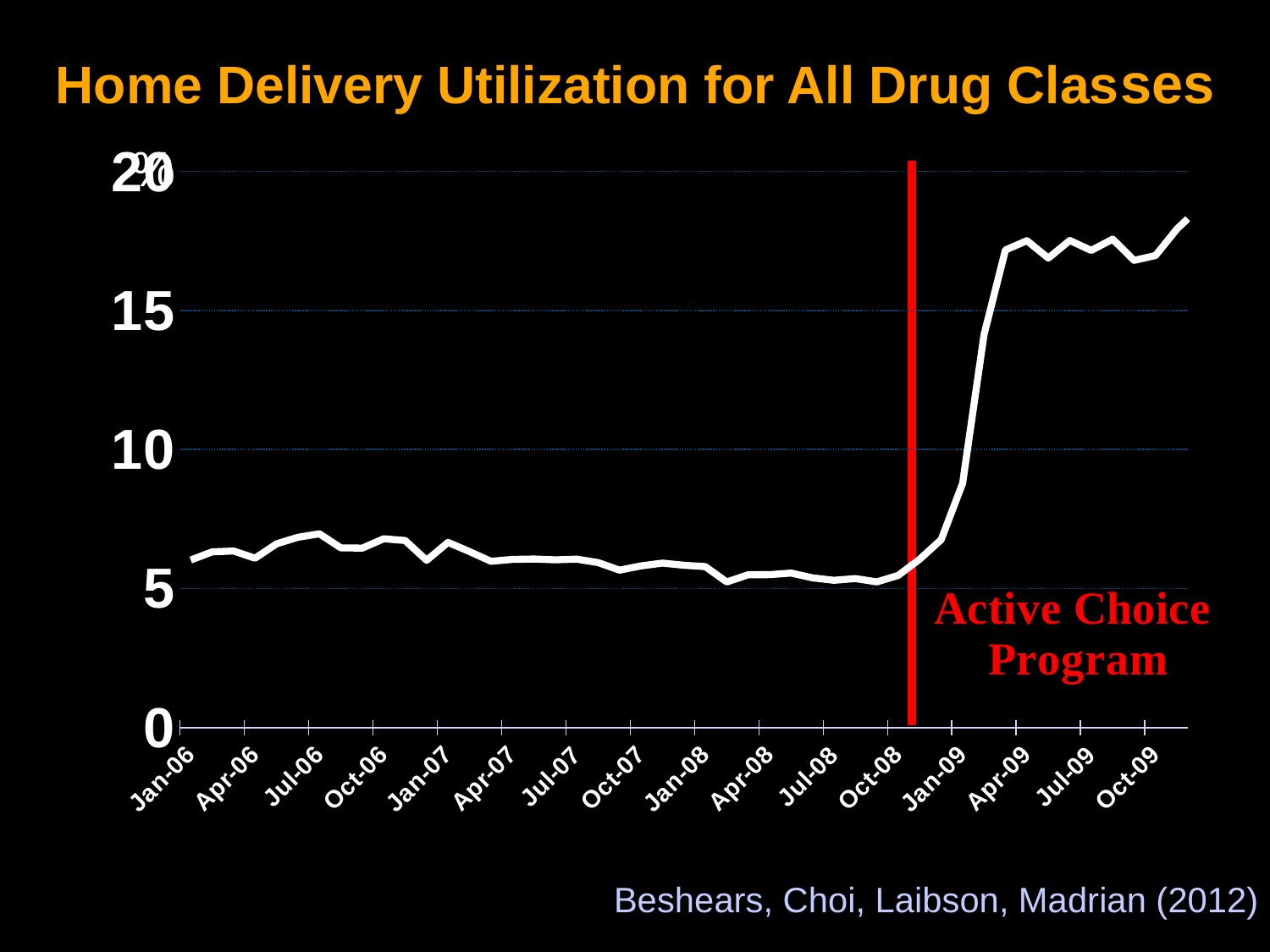
What label is written next to the red vertical line on the chart? Active Choice Program How many date labels are shown along the x axis? 16 Is the value for Jan-06 greater or less than 10? less Which is larger, the value for Apr-08 or the value for Apr-09? Apr-09 What is the title of the chart? Home Delivery Utilization for All Drug Classes Does the line rise or fall sharply immediately after the red vertical line marking the Active Choice Program? rise What kind of chart is shown on the slide? line chart Is the value for Oct-09 greater or less than 15? greater Overall, from Jan-06 to the end of the series, do the values rise or fall? rise Is the value for Jan-09 greater or less than 10? less